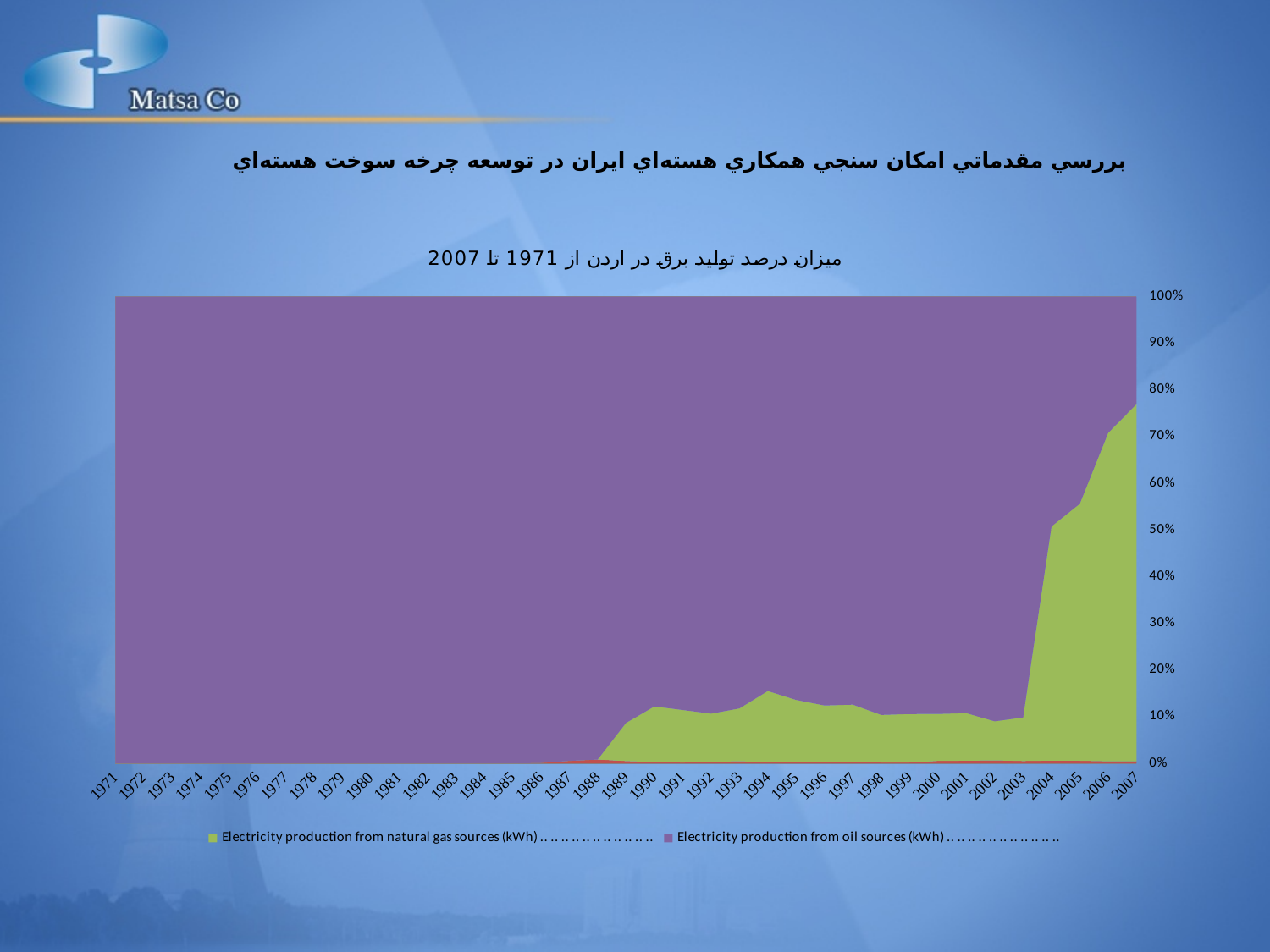
How many years are shown along the x axis of the chart? 37 What kind of chart is shown on the slide? area chart Is the share of electricity production from natural gas sources in 2003 greater or less than 20%? less Is the share of electricity production from natural gas sources in 2007 greater or less than 70%? greater Which is larger in 2000: the share of electricity production from oil sources or from natural gas sources? oil sources Which colour represents electricity production from natural gas sources in the chart? green In which year is the share of electricity production from natural gas sources highest? 2007 Is the share of electricity production from natural gas sources larger in 2007 or in 1990? 2007 What is the first year shown on the x axis of the chart? 1971 Is the share of electricity production from oil sources in 1985 greater or less than 90%? greater Does the share of electricity production from natural gas sources rise or fall from 1971 to 2007? rise How many series does the chart legend list? 2